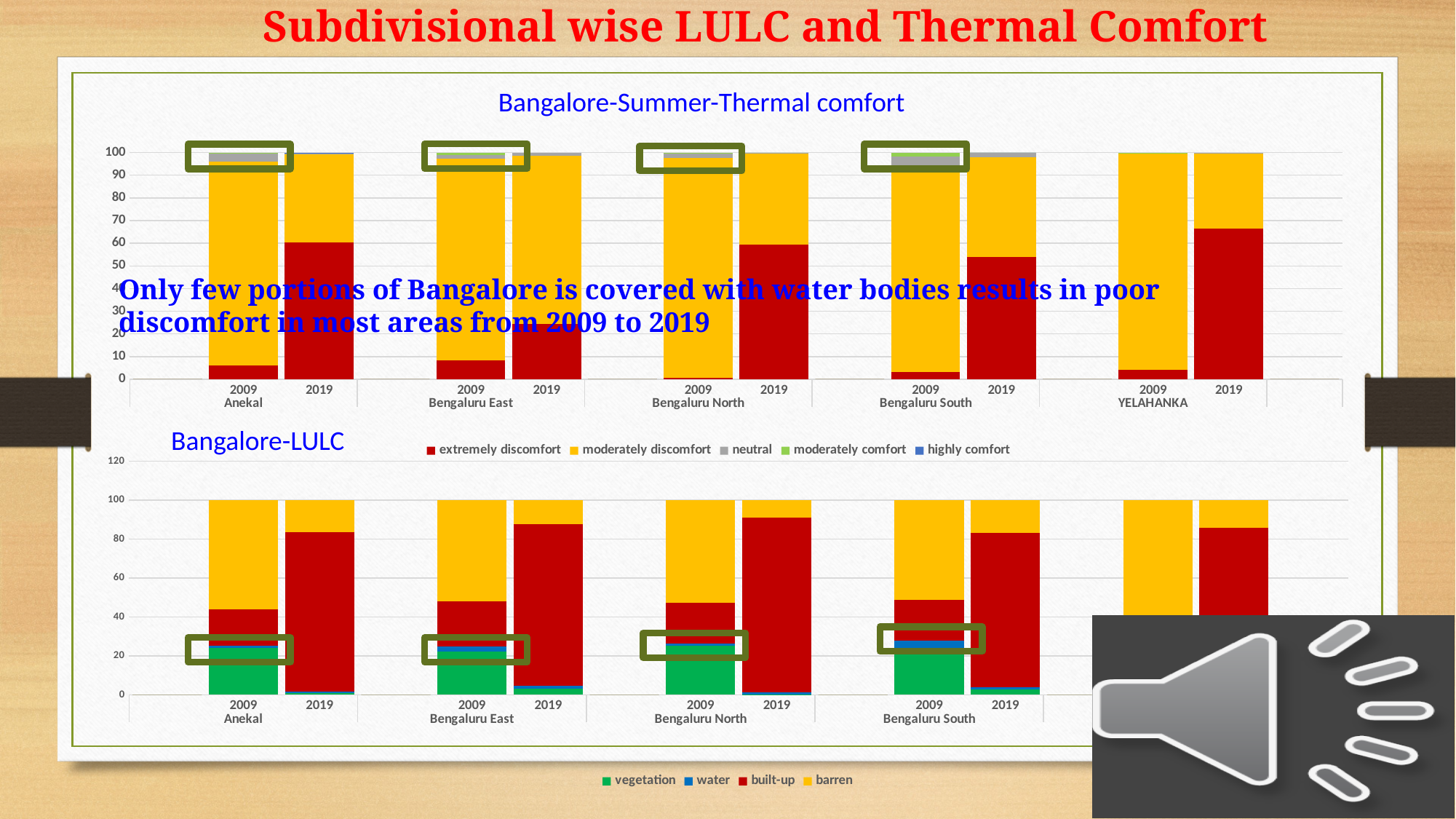
In the Bangalore-Summer-Thermal comfort chart, does the extremely discomfort value for Bengaluru North rise or fall from 2009 to 2019? rise In the Bangalore-LULC chart, is the built-up value for Bengaluru North 2019 greater or less than 80? greater How many series does the legend of the Bangalore-Summer-Thermal comfort chart list? 5 In the Bangalore-LULC chart, which colour represents built-up? Red In the Bangalore-Summer-Thermal comfort chart, which has the larger extremely discomfort value: YELAHANKA 2019 or Bengaluru South 2019? YELAHANKA 2019 In the Bangalore-Summer-Thermal comfort chart, how many bars are plotted in total? 10 In the Bangalore-Summer-Thermal comfort chart, is the extremely discomfort value for YELAHANKA 2019 greater or less than 60? greater In the Bangalore-Summer-Thermal comfort chart, is the extremely discomfort value for Anekal 2019 greater or less than 50? greater How many series does the legend of the Bangalore-LULC chart list? 4 In the Bangalore-LULC chart, does the vegetation value for Anekal rise or fall from 2009 to 2019? fall What kind of chart is the Bangalore-Summer-Thermal comfort chart? Stacked bar chart